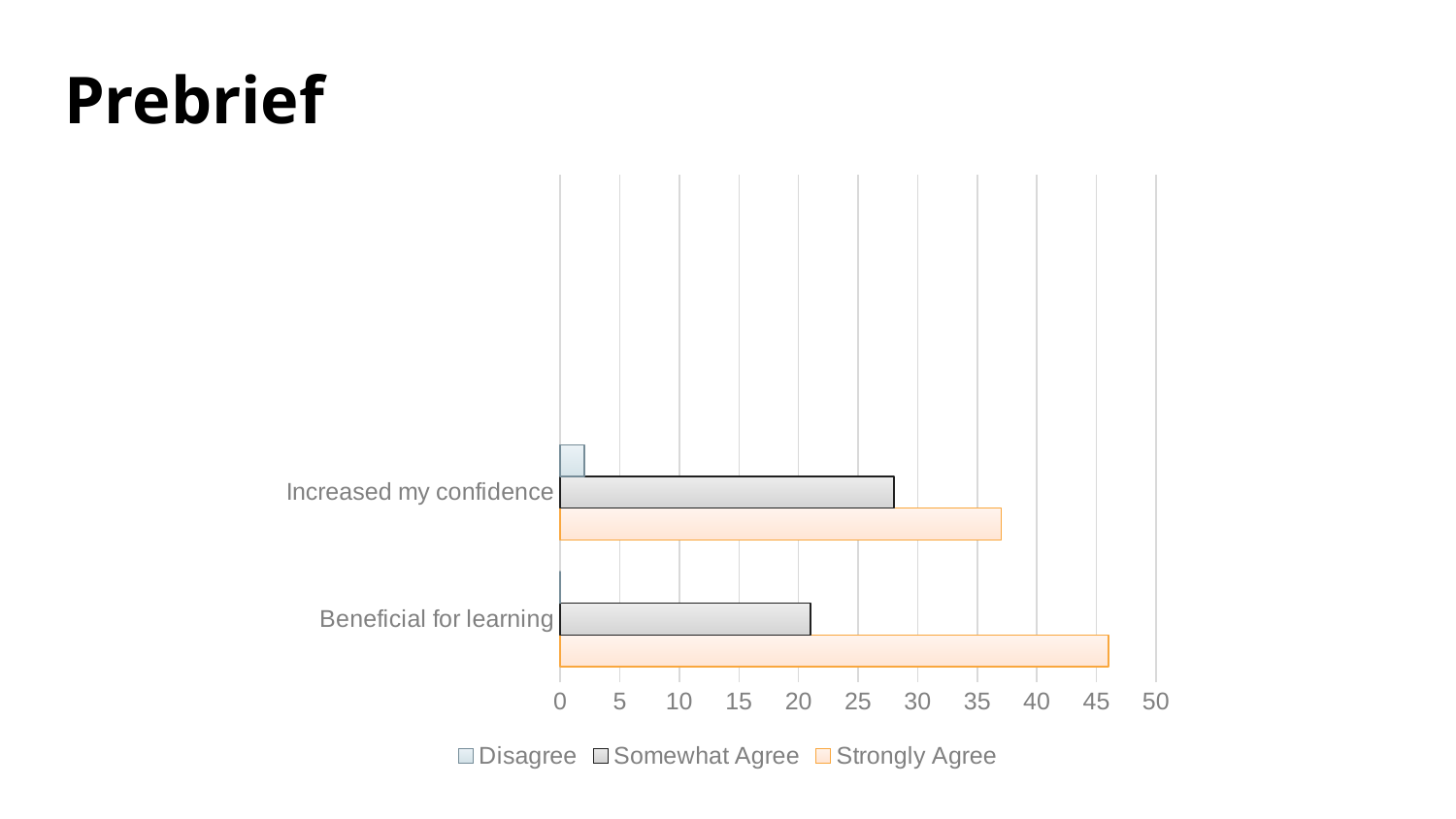
Is the Disagree value for Increased my confidence greater or less than 5? less For Beneficial for learning, which series has the highest value? Strongly Agree For Increased my confidence, which series has the lowest value? Disagree Which category has the higher Strongly Agree value, Increased my confidence or Beneficial for learning? Beneficial for learning How many categories are shown on the vertical axis? 2 Is the Strongly Agree value for Increased my confidence greater or less than 40? less How many series does the legend list? 3 Is the Strongly Agree value for Beneficial for learning greater or less than 40? greater What kind of chart is shown on the slide? bar chart Which category has the higher Somewhat Agree value, Increased my confidence or Beneficial for learning? Increased my confidence